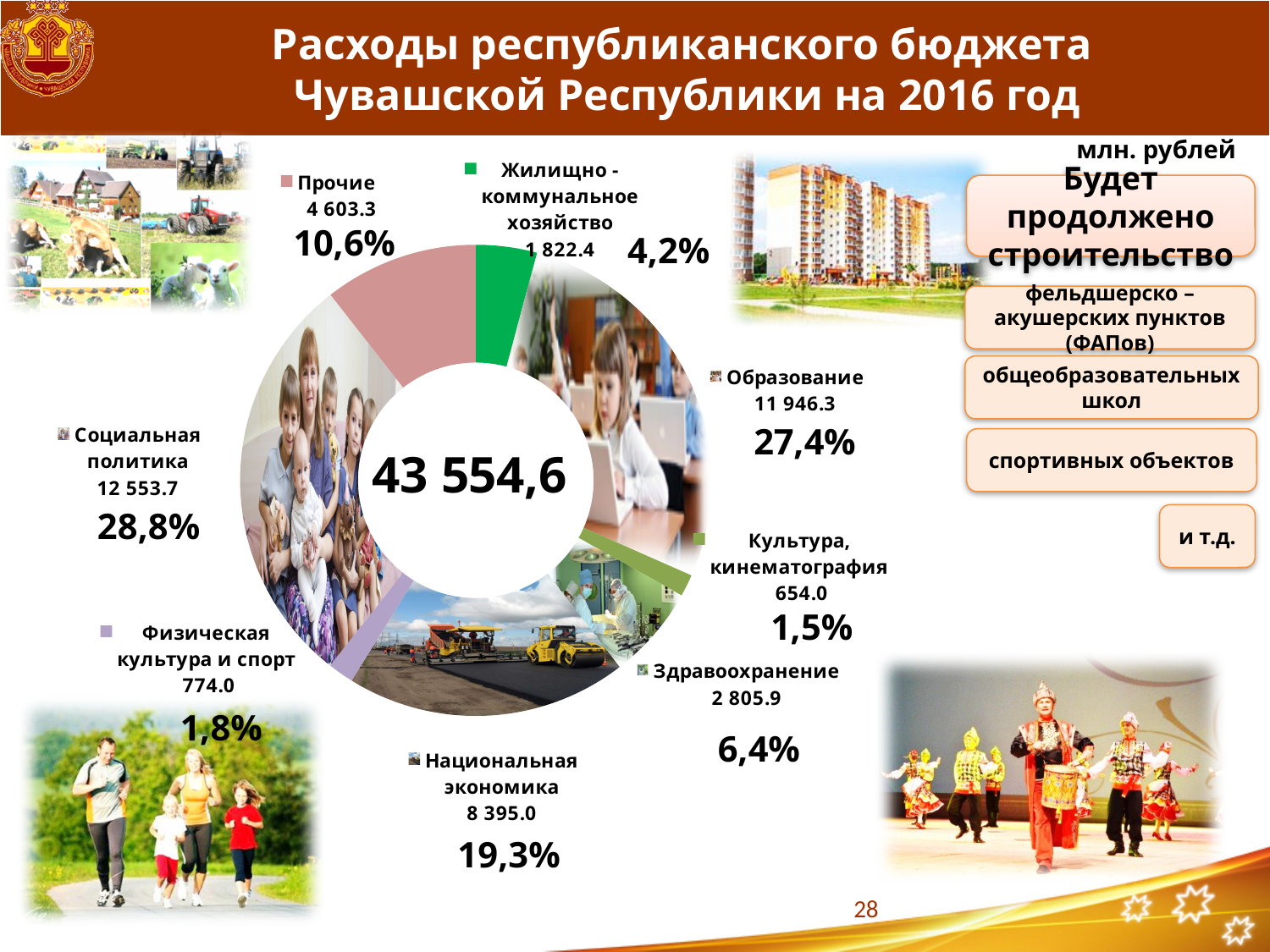
What type of chart is shown on the slide? Pie (doughnut) chart What is the difference between the values for Образование and Здравоохранение? 9 140.4 What share of the pie does Социальная политика represent? 28,8% What is the value for Здравоохранение? 2 805.9 Which category has the largest value in the pie chart? Социальная политика What total value is shown in the centre of the pie chart? 43 554,6 How many categories does the pie chart show? 8 What is the value for Национальная экономика? 8 395.0 What share of the pie does Жилищно-коммунальное хозяйство represent? 4,2% Which is larger, Прочие or Здравоохранение? Прочие What is the value for Образование in the pie chart? 11 946.3 Which category has the smallest value in the pie chart? Культура, кинематография